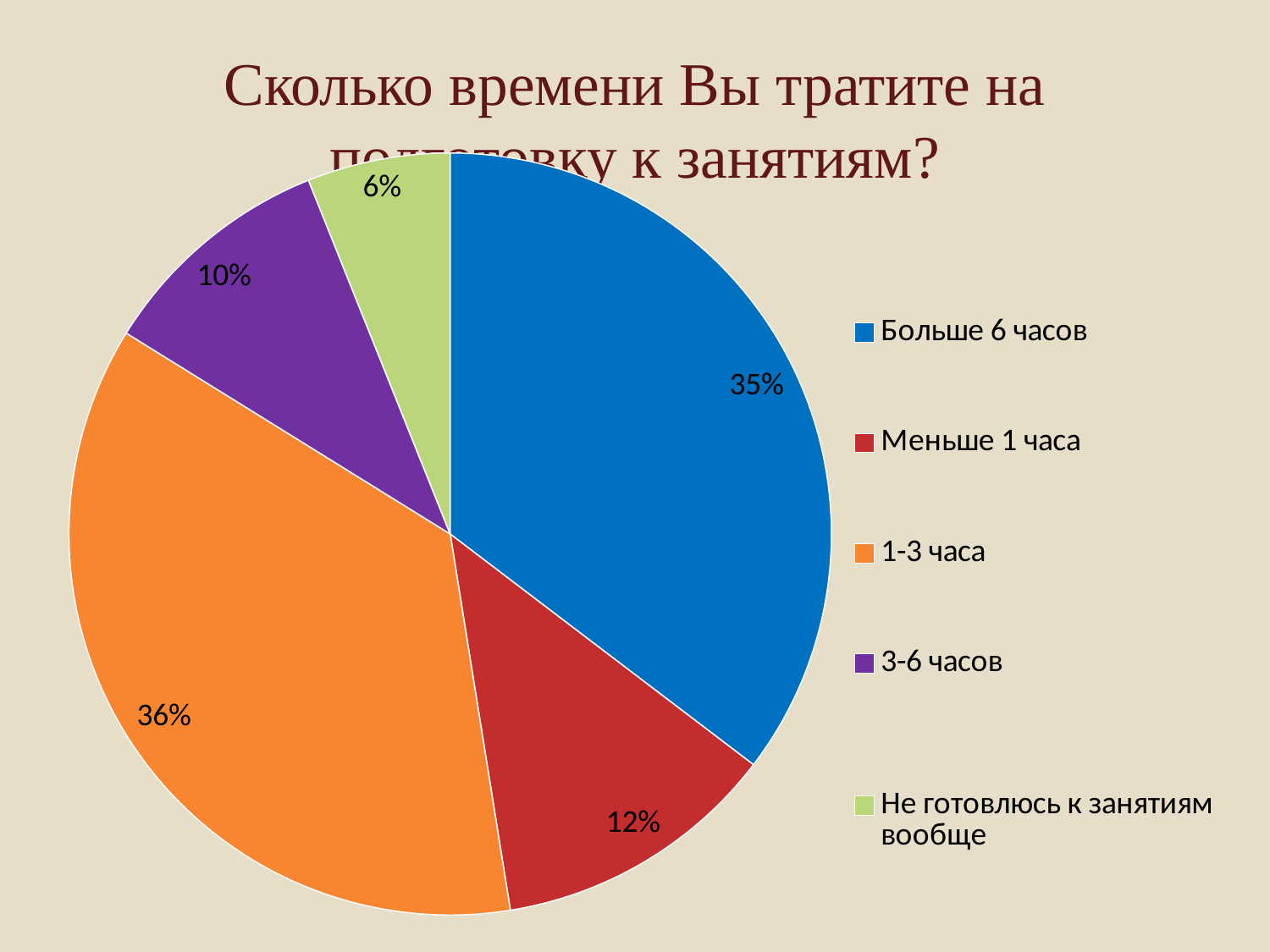
What percentage of respondents chose "3-6 часов"? 10% What percentage of respondents chose "Больше 6 часов"? 35% Which category has the largest share of the pie? 1-3 часа What is the difference in percentage points between "Меньше 1 часа" and "3-6 часов"? 2 What colour is the slice for "3-6 часов"? purple How many categories does the pie chart have? 5 Which is larger: the share for "Больше 6 часов" or the share for "Меньше 1 часа"? Больше 6 часов What percentage of respondents chose "Не готовлюсь к занятиям вообще"? 6% What percentage of respondents chose "Меньше 1 часа"? 12% What percentage of respondents chose "1-3 часа"? 36% What kind of chart is shown on the slide? pie chart Which category has the smallest share of the pie? Не готовлюсь к занятиям вообще